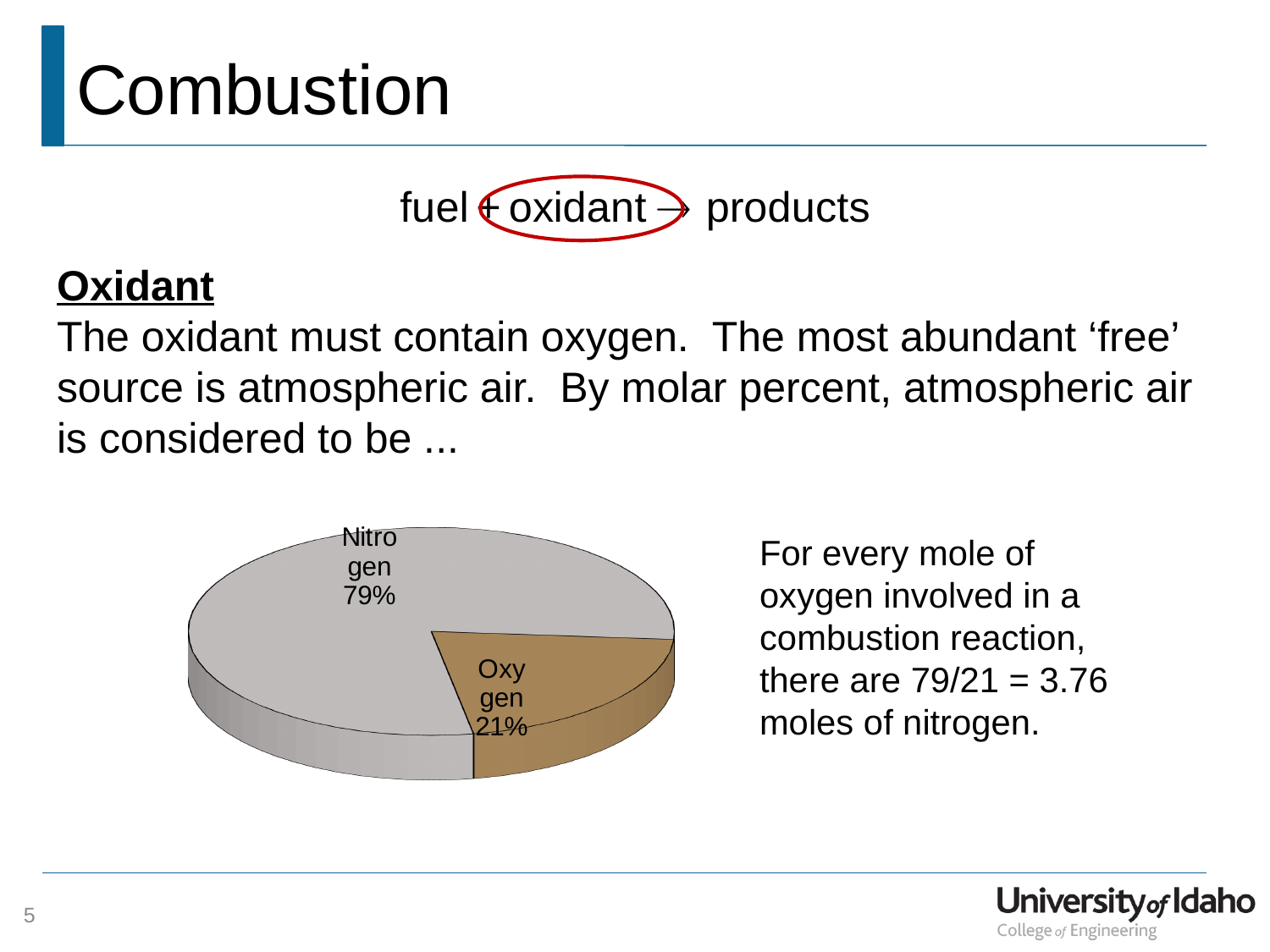
What percentage of the pie chart is Oxygen? 21% How many slices does the pie chart have? 2 What percentage of the pie chart is Nitrogen? 79% Which is larger in the pie chart, Nitrogen or Oxygen? Nitrogen What do the two slices of the pie chart add up to? 100% What is the difference in percentage points between the Nitrogen and Oxygen slices? 58 What colour is the Nitrogen slice in the pie chart? grey What colour is the Oxygen slice in the pie chart? brown Which slice of the pie chart is the largest? Nitrogen Which slice of the pie chart is the smallest? Oxygen What kind of chart is shown on the slide? pie chart What share of the pie does the Oxygen slice represent? 21%